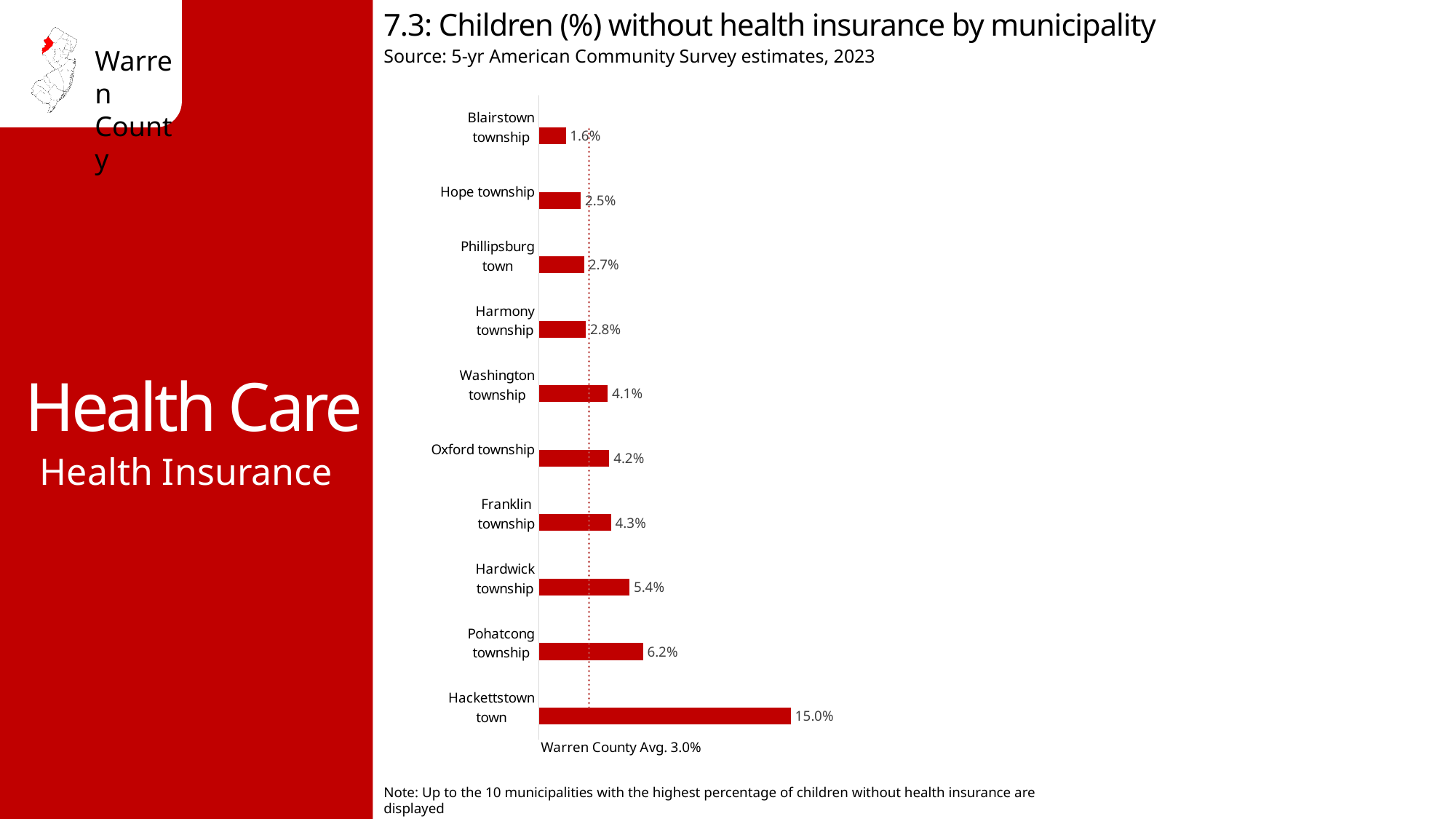
What kind of chart is shown on the slide? Bar chart Which municipality has the lowest percentage of children without health insurance? Blairstown township What is the difference between the values for Hackettstown town and Pohatcong township? 8.8% What is the value shown for Washington township? 4.1% What percentage of children are without health insurance in Hackettstown town? 15.0% Which has a higher value, Oxford township or Phillipsburg town? Oxford township What is the difference between the values for Hardwick township and Blairstown township? 3.8% What is the title of the chart? 7.3: Children (%) without health insurance by municipality How many municipalities are shown in the chart? 10 Which municipality has the highest percentage of children without health insurance? Hackettstown town What is the value shown for Hope township? 2.5% What is the Warren County average shown on the chart? 3.0%